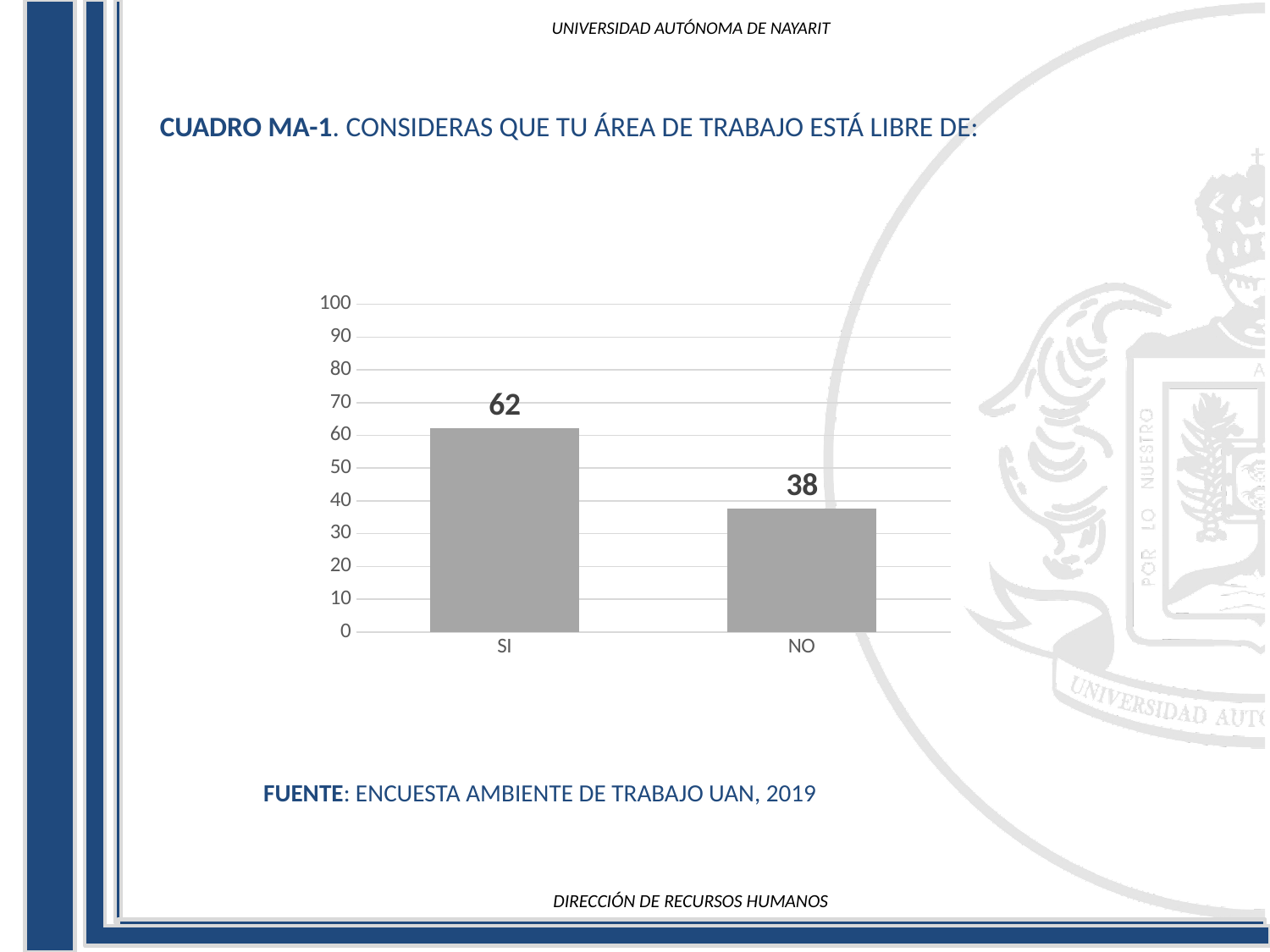
What is the value for SI? 62 What is the difference between the values for SI and NO? 24 Is the value for NO greater or less than 50? less Which category has the lowest value? NO Is the value for SI greater or less than 60? greater What is the highest value shown on the y axis? 100 What is the total of the values for SI and NO? 100 What is the value for NO? 38 Which is larger, the value for SI or the value for NO? SI How many categories are shown on the x axis? 2 Which category has the highest value? SI What kind of chart is shown on the slide? bar chart